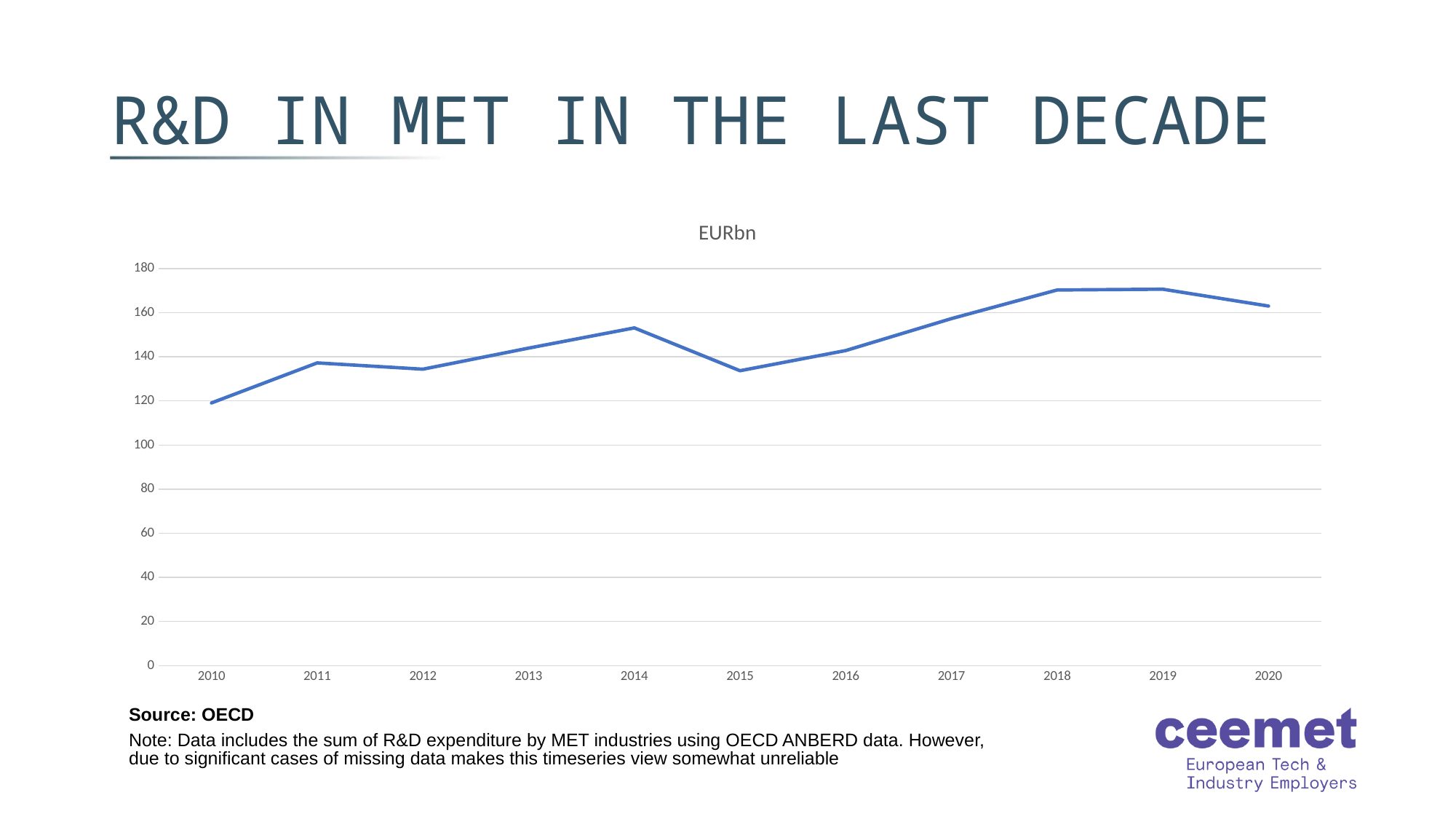
What is the title shown above the chart? EURbn Is the value for 2010 greater or less than 140? less Is the value for 2015 greater or less than 140? less Which year has the larger value, 2010 or 2020? 2020 Is the value for 2017 greater or less than 140? greater Which year has the lowest value in the chart? 2010 How many years are plotted on the x axis of the chart? 11 What kind of chart is shown on the slide? line chart Overall, do the values rise or fall from 2010 to 2020? rise Which year has the larger value, 2014 or 2015? 2014